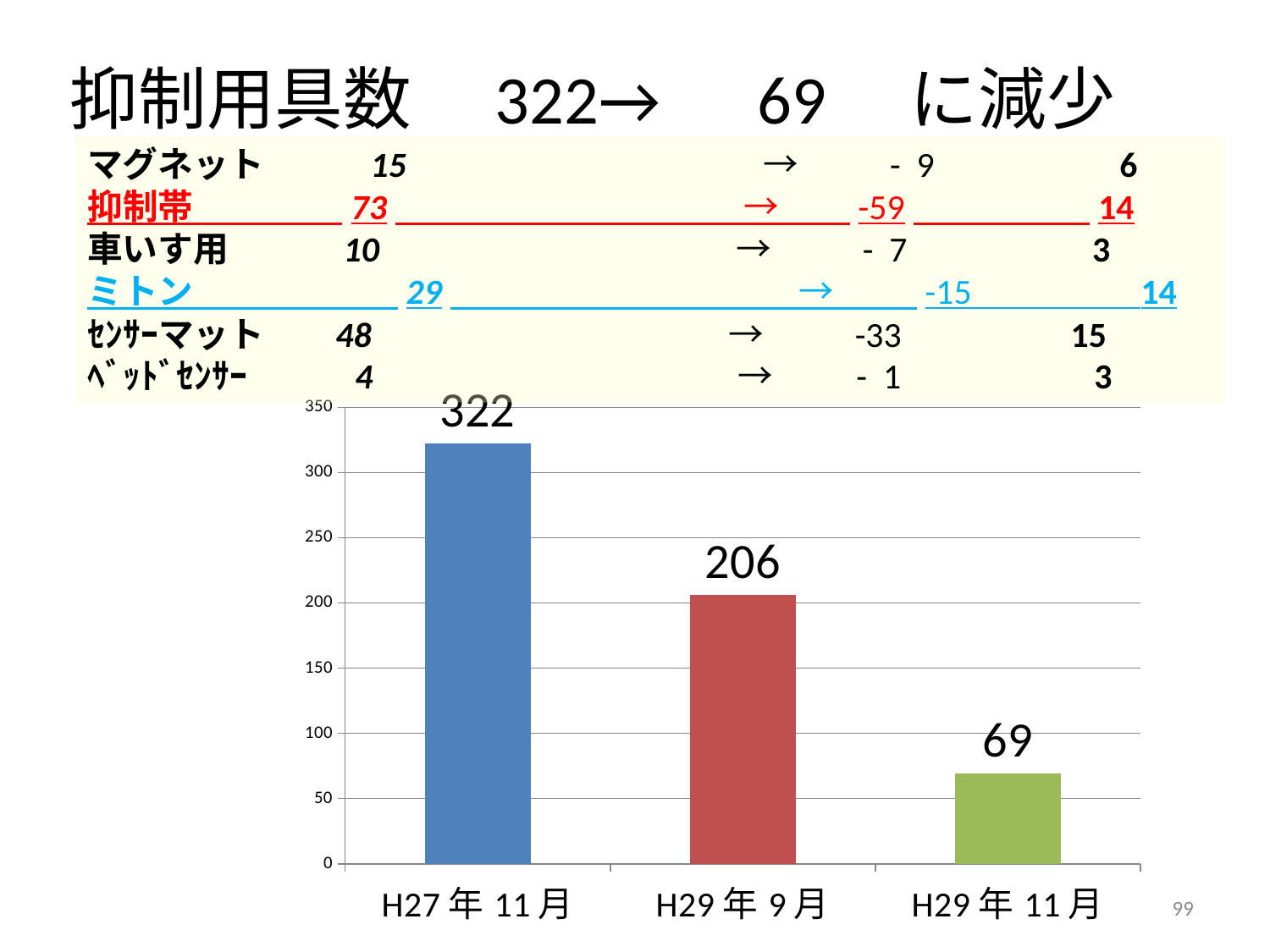
Which category has the lowest value? H29年11月 Which category has the highest value? H27年11月 What kind of chart is shown on the slide? bar chart What is the difference between the values for H27年11月 and H29年11月? 253 Do the values rise or fall from left to right along the x axis? fall What is the value for H29年11月? 69 Which is larger, the value for H29年9月 or the value for H29年11月? H29年9月 How many categories are shown on the x axis? 3 What is the difference between the values for H29年9月 and H29年11月? 137 What is the value for H27年11月? 322 Is the value for H29年9月 greater or less than 200? greater What is the value for H29年9月? 206